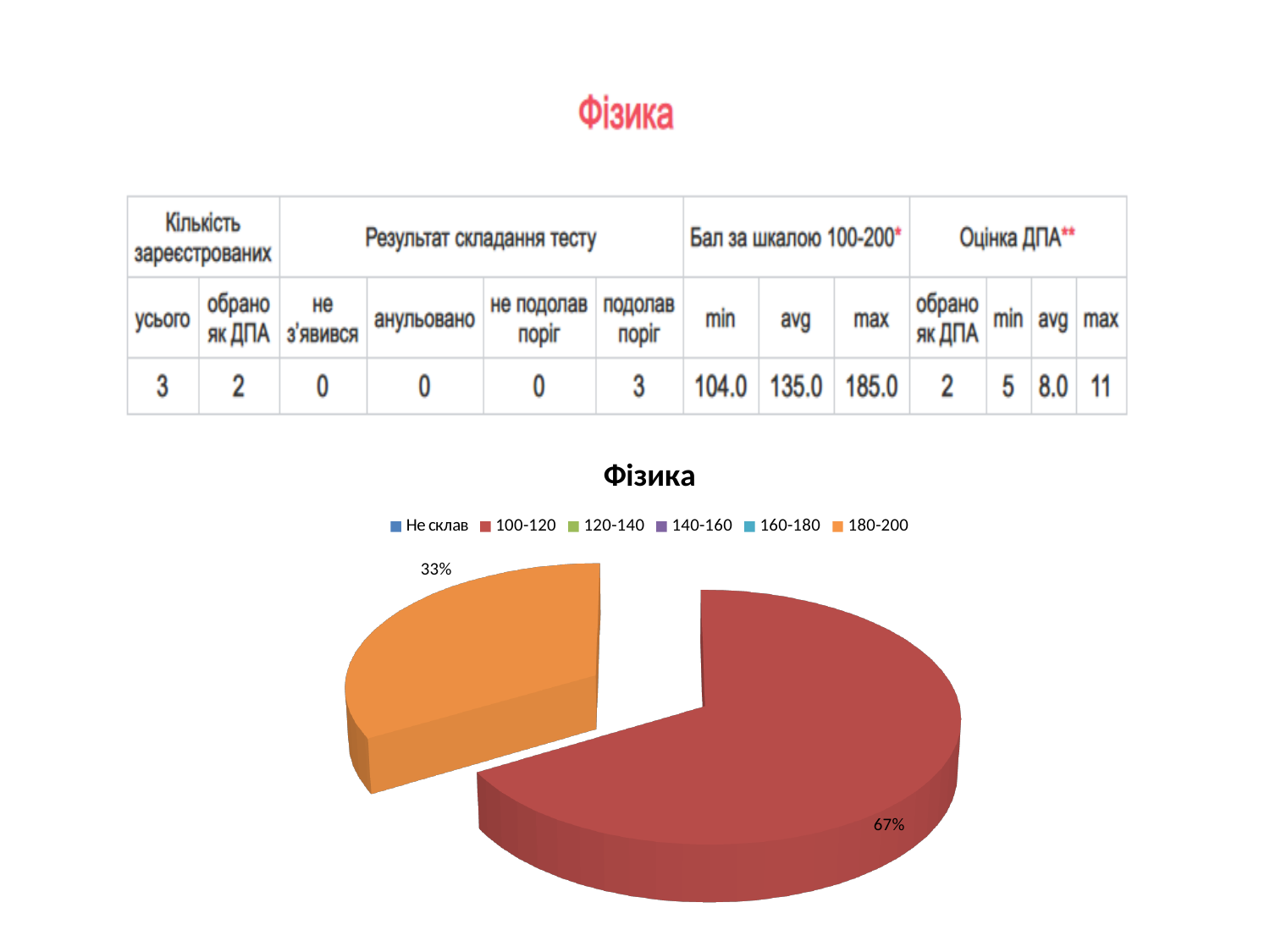
Is the share of the 100-120 slice greater or less than 50%? greater How many slices are visible in the pie chart? 2 What share of the pie does the 100-120 slice represent? 67% Which category has the largest slice of the pie? 100-120 What colour is the 180-200 slice in the pie chart? orange How many entries does the chart legend list? 6 What type of chart is shown on the slide? pie chart Which of the two visible slices is smaller, 100-120 or 180-200? 180-200 What is the title of the chart? Фізика What share of the pie does the 180-200 slice represent? 33% What is the difference in percentage points between the 100-120 slice and the 180-200 slice? 34